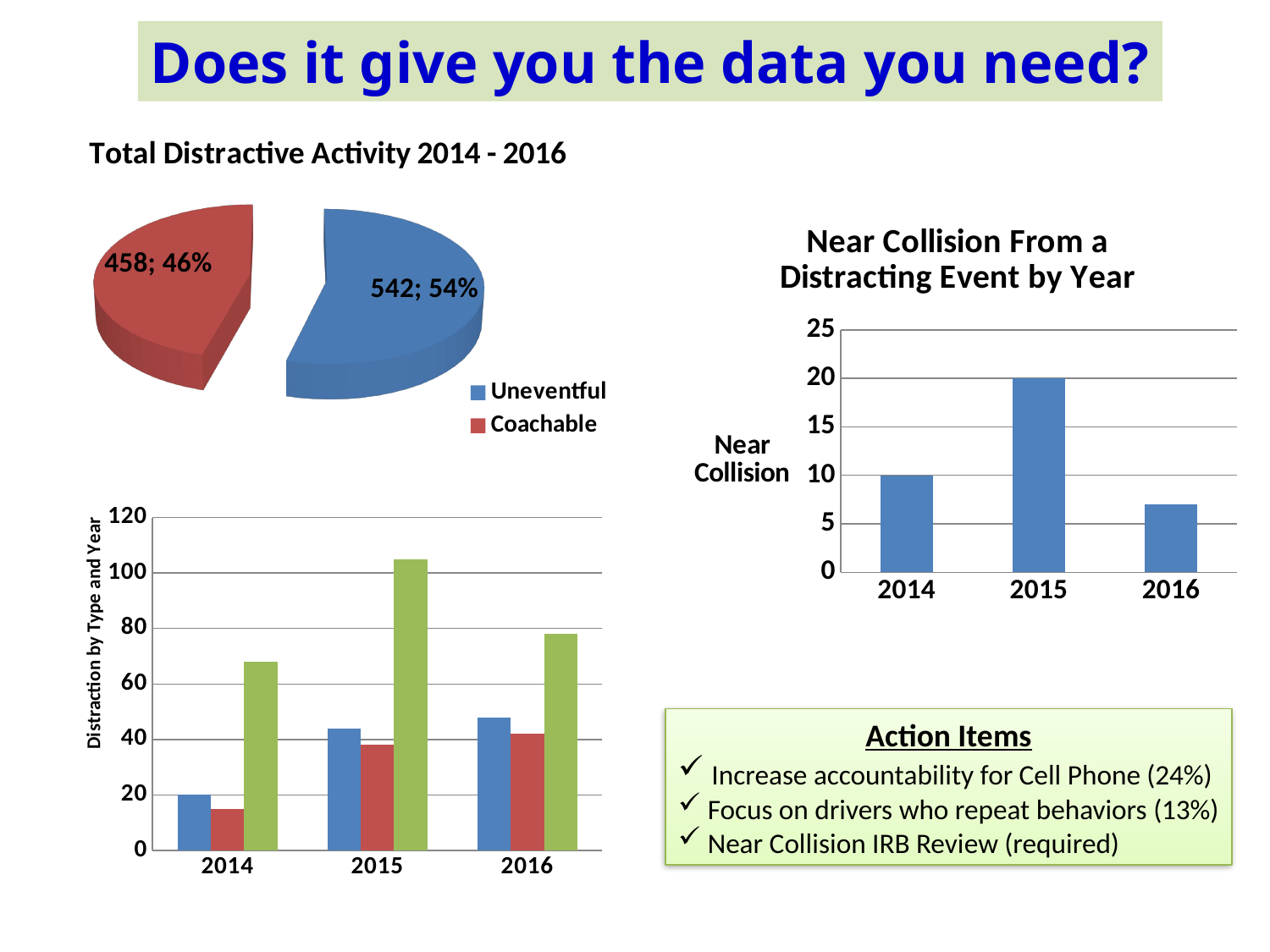
What kind of chart is 'Total Distractive Activity 2014 - 2016'? Pie chart In the chart 'Near Collision From a Distracting Event by Year', is the value for 2016 greater or less than 10? less In the chart 'Near Collision From a Distracting Event by Year', what is the difference between the 2015 and 2014 values? 10 In the chart 'Near Collision From a Distracting Event by Year', what is the value for 2014? 10 In the pie chart titled 'Total Distractive Activity 2014 - 2016', what share of the pie is Coachable? 46% In the pie chart titled 'Total Distractive Activity 2014 - 2016', which slice is larger, Uneventful or Coachable? Uneventful In the chart 'Near Collision From a Distracting Event by Year', which year has the lowest value? 2016 In the pie chart titled 'Total Distractive Activity 2014 - 2016', how many entries does the legend list? 2 In the chart 'Near Collision From a Distracting Event by Year', what is the value for 2015? 20 In the bar chart at the bottom left of the slide (y axis 'Distraction by Type and Year'), how many years are shown on the x axis? 3 In the pie chart titled 'Total Distractive Activity 2014 - 2016', what value is shown for the Uneventful slice? 542; 54% In the chart 'Near Collision From a Distracting Event by Year', which year has the highest value? 2015